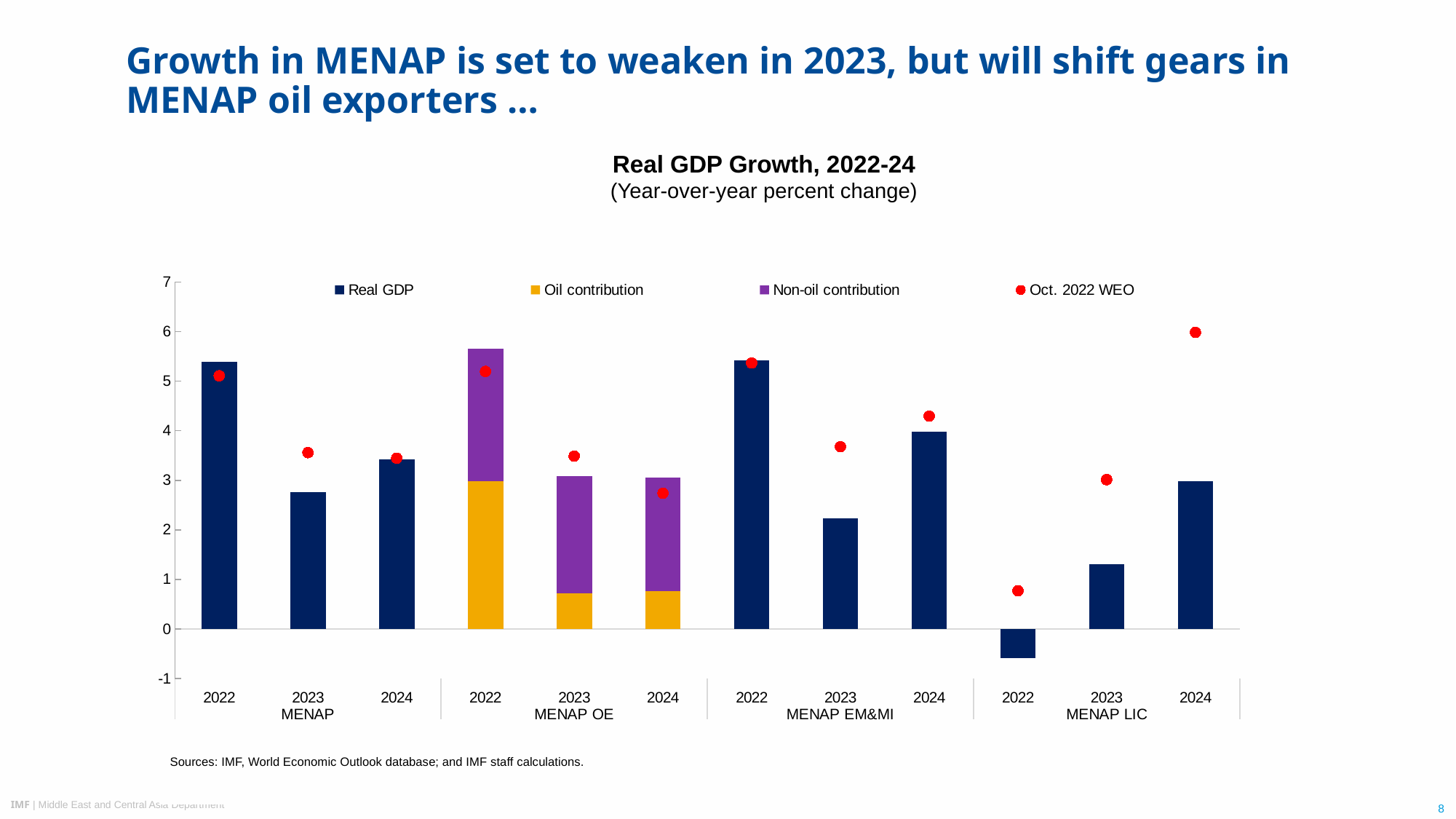
Is the Oct. 2022 WEO marker for MENAP LIC in 2024 greater or less than 5? greater How many series does the legend list? 4 Which bar shows the highest real GDP growth? MENAP OE 2022 Which bar shows the lowest real GDP growth? MENAP LIC 2022 Do the real GDP growth bars for MENAP LIC rise or fall from 2022 to 2024? rise Is the real GDP growth bar for MENAP LIC in 2022 greater or less than 0? less Is the real GDP growth bar for MENAP EM&MI in 2023 greater or less than 3? less Which region group has its bars split into oil and non-oil contributions? MENAP OE What kind of chart is shown on the slide? bar chart For MENAP, which year has the larger real GDP growth bar, 2023 or 2024? 2024 How many bars are plotted in the chart? 12